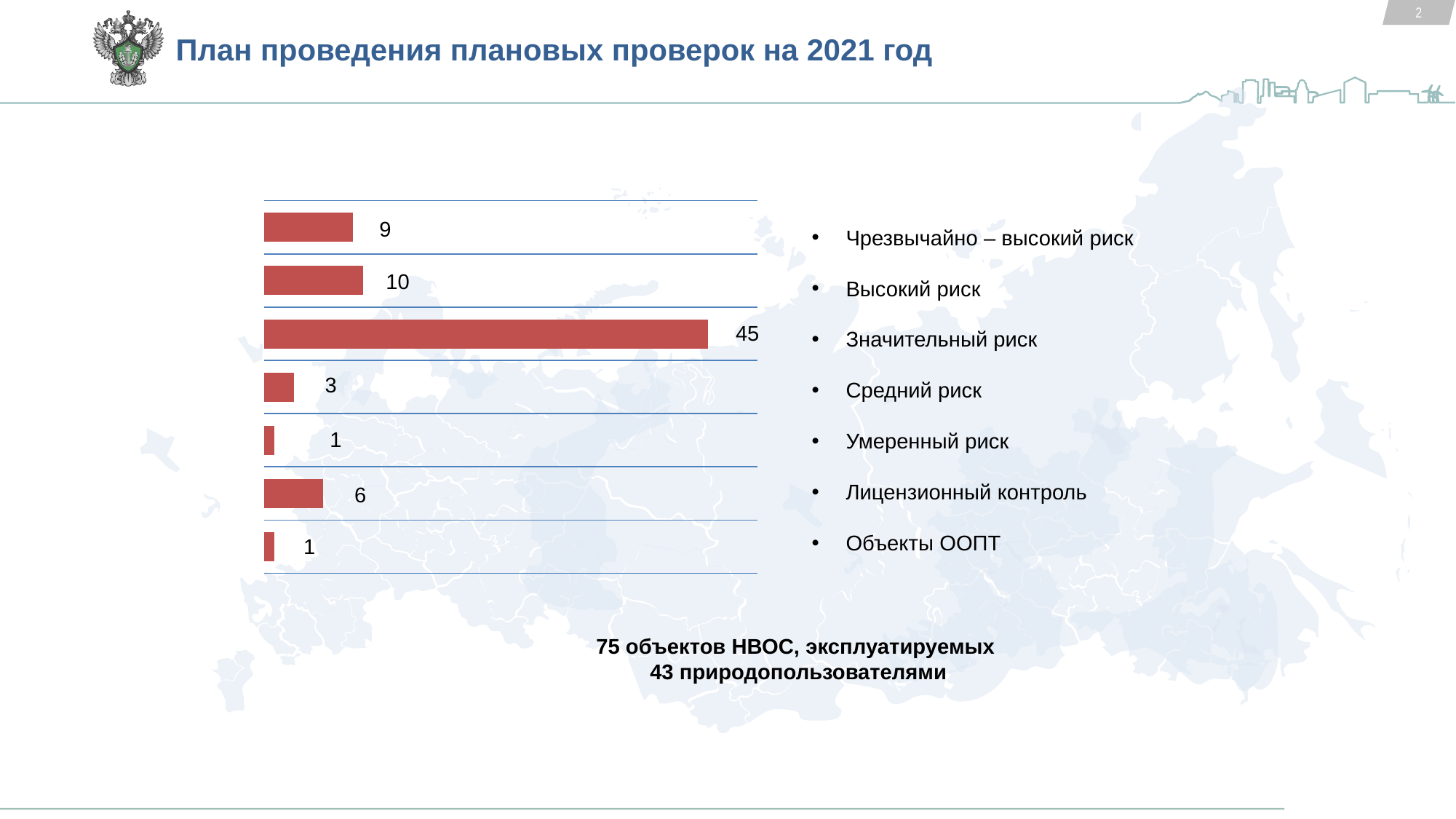
Which category has the highest value in the chart? Значительный риск What type of chart is shown on the slide? bar chart What is the value of the bar for "Высокий риск"? 10 What is the title of the slide containing the chart? План проведения плановых проверок на 2021 год What is the value of the bar for "Чрезвычайно – высокий риск"? 9 What is the difference between the values for "Значительный риск" and "Высокий риск"? 35 What is the value of the bar for "Средний риск"? 3 What is the value of the bar for "Значительный риск"? 45 What is the value of the bar for "Лицензионный контроль"? 6 Which is larger, the value for "Высокий риск" or the value for "Чрезвычайно – высокий риск"? Высокий риск How many bars does the chart contain? 7 What is the difference between the values for "Лицензионный контроль" and "Средний риск"? 3